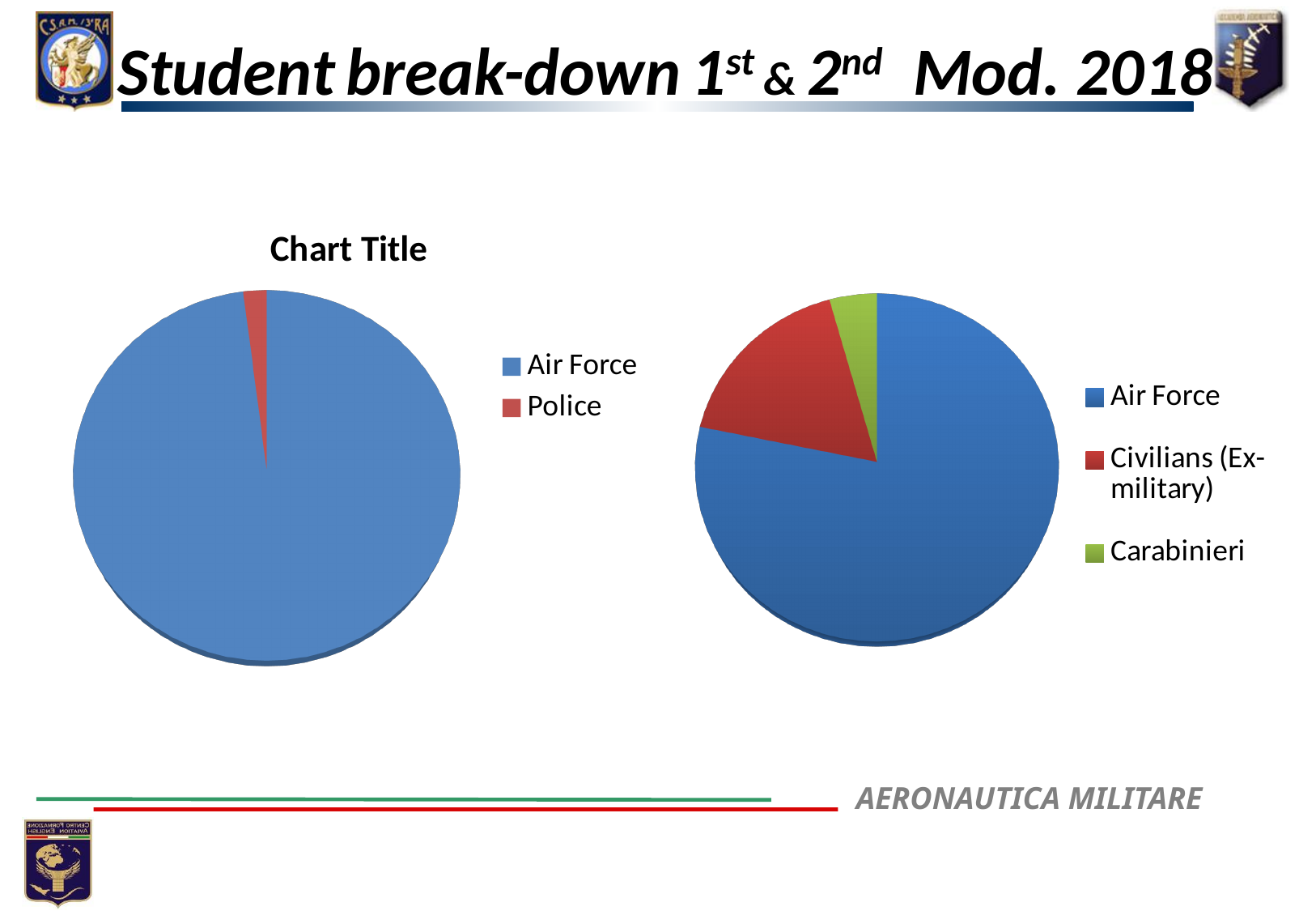
In the right chart, which slice is larger: Civilians (Ex-military) or Carabinieri? Civilians (Ex-military) In the left chart titled "Chart Title", how many categories does the legend list? 2 In the left chart, which slice is larger: Air Force or Police? Air Force In the right chart, which category has the largest slice? Air Force In the right chart, how many categories does the legend list? 3 In the right chart, what colour is the Carabinieri slice? green What kind of chart is the right chart on the slide? pie chart In the left chart titled "Chart Title", which category has the largest slice? Air Force In the left chart titled "Chart Title", which category has the smallest slice? Police In the right chart, which category has the smallest slice? Carabinieri What kind of chart is the left chart titled "Chart Title"? pie chart What is the title of the left chart? Chart Title